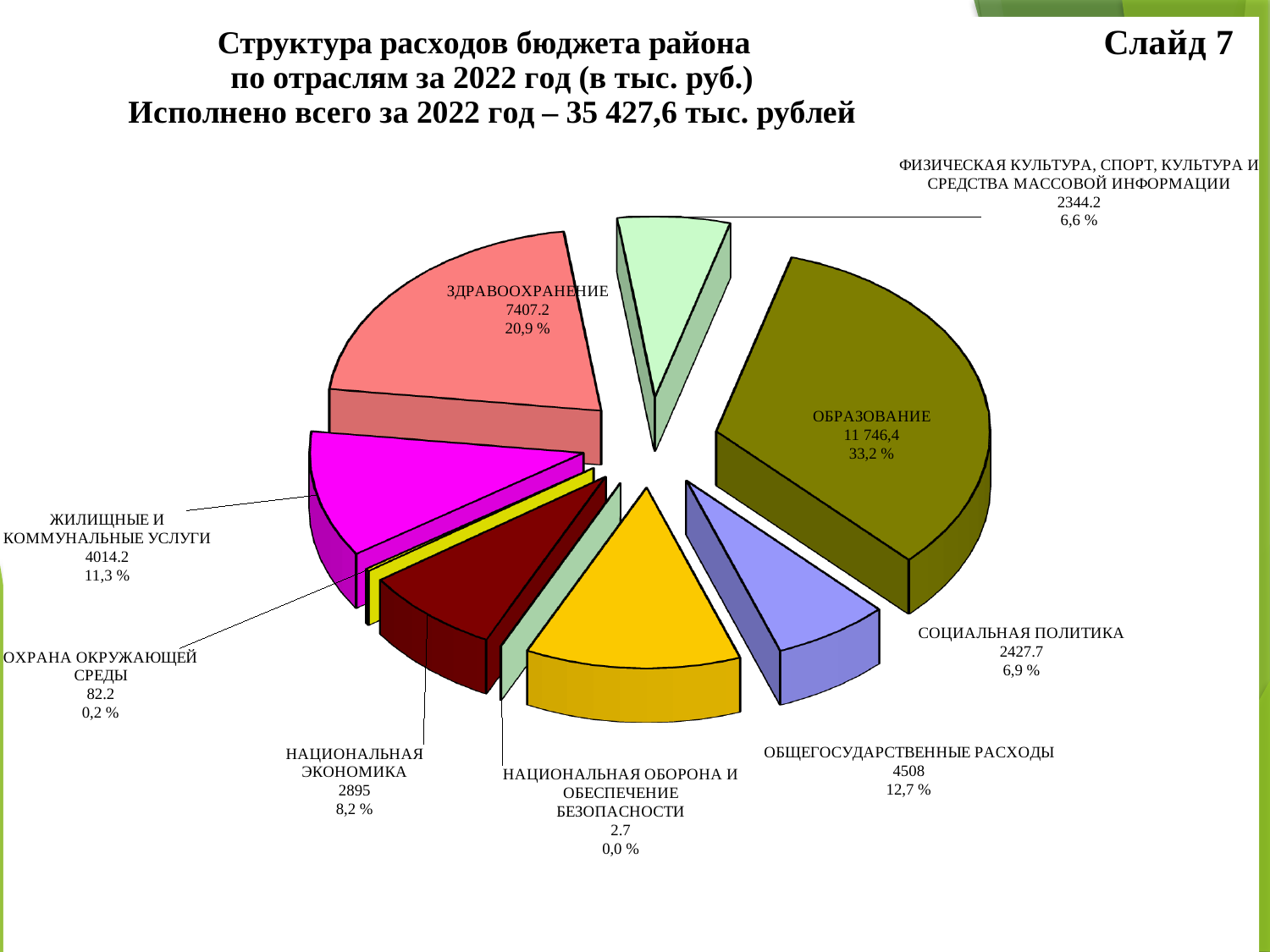
What kind of chart is shown on the slide? pie chart Which category has the largest share of the pie? ОБРАЗОВАНИЕ What is the value for ОБРАЗОВАНИЕ? 11 746,4 Which category has the smallest share of the pie? НАЦИОНАЛЬНАЯ ОБОРОНА И ОБЕСПЕЧЕНИЕ БЕЗОПАСНОСТИ What is the value for ОХРАНА ОКРУЖАЮЩЕЙ СРЕДЫ? 82.2 What is the value for ЗДРАВООХРАНЕНИЕ? 7407.2 What is the difference between the values for ОБЩЕГОСУДАРСТВЕННЫЕ РАСХОДЫ and НАЦИОНАЛЬНАЯ ЭКОНОМИКА? 1613 Which is larger, the value for СОЦИАЛЬНАЯ ПОЛИТИКА or the value for ФИЗИЧЕСКАЯ КУЛЬТУРА, СПОРТ, КУЛЬТУРА И СРЕДСТВА МАССОВОЙ ИНФОРМАЦИИ? СОЦИАЛЬНАЯ ПОЛИТИКА What share of the pie does СОЦИАЛЬНАЯ ПОЛИТИКА represent? 6,9 % How many categories (slices) does the pie chart show? 9 What is the value for ОБЩЕГОСУДАРСТВЕННЫЕ РАСХОДЫ? 4508 What share of the pie does ЖИЛИЩНЫЕ И КОММУНАЛЬНЫЕ УСЛУГИ represent? 11,3 %